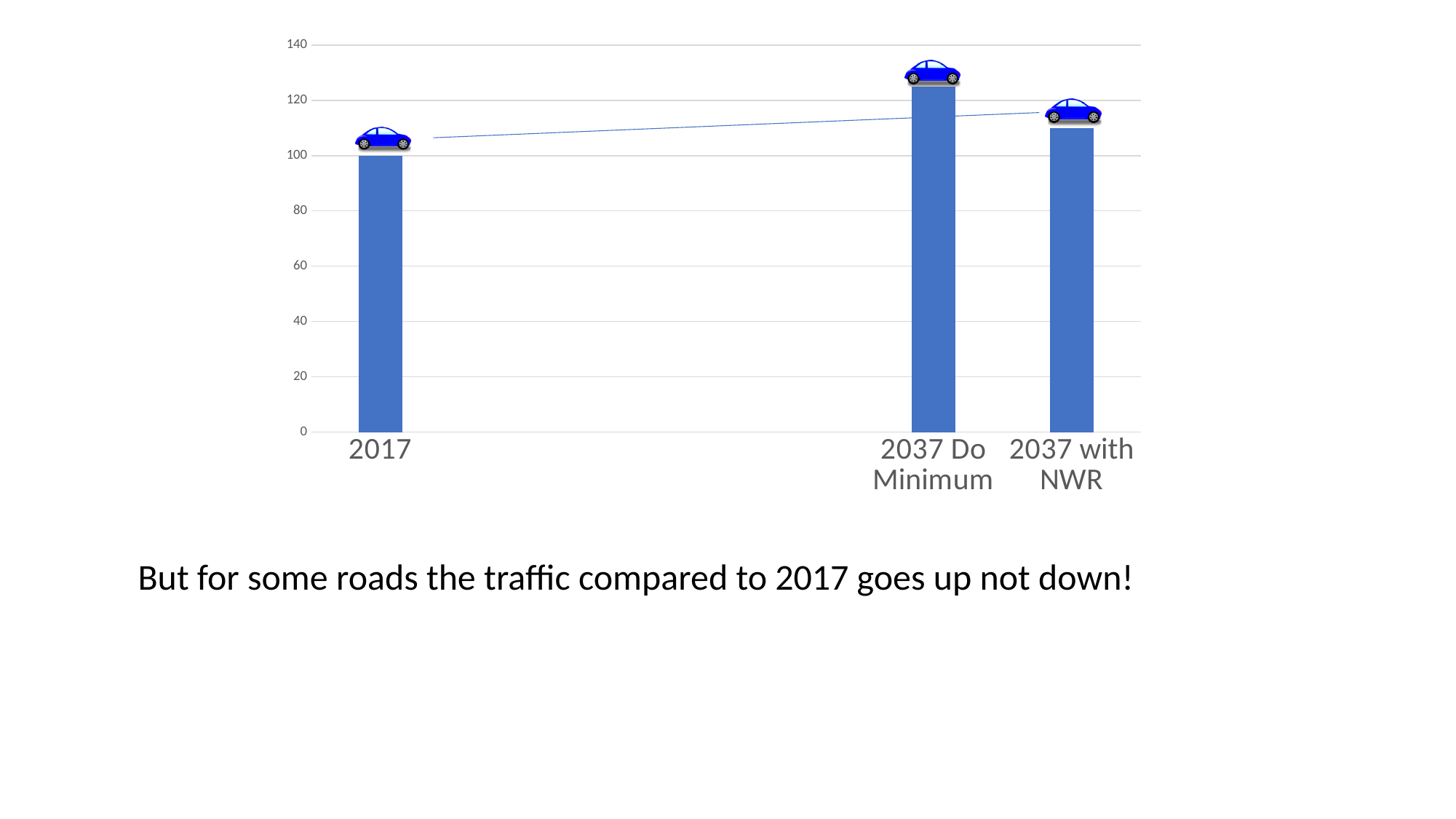
What is the text written below the chart? But for some roads the traffic compared to 2017 goes up not down! Which category has the lowest bar? 2017 What kind of chart is shown on the slide? bar chart Is the value for 2037 Do Minimum greater or less than 120? greater Which is larger, the bar for 2017 or the bar for 2037 with NWR? 2037 with NWR What is the highest value shown on the vertical axis? 140 How many bars are plotted in the chart? 3 Is the value for 2037 with NWR greater or less than 100? greater Is the value for 2037 with NWR greater or less than 120? less Which category has the highest bar? 2037 Do Minimum What is the value of the bar for 2017? 100 Which is larger, the bar for 2037 Do Minimum or the bar for 2037 with NWR? 2037 Do Minimum